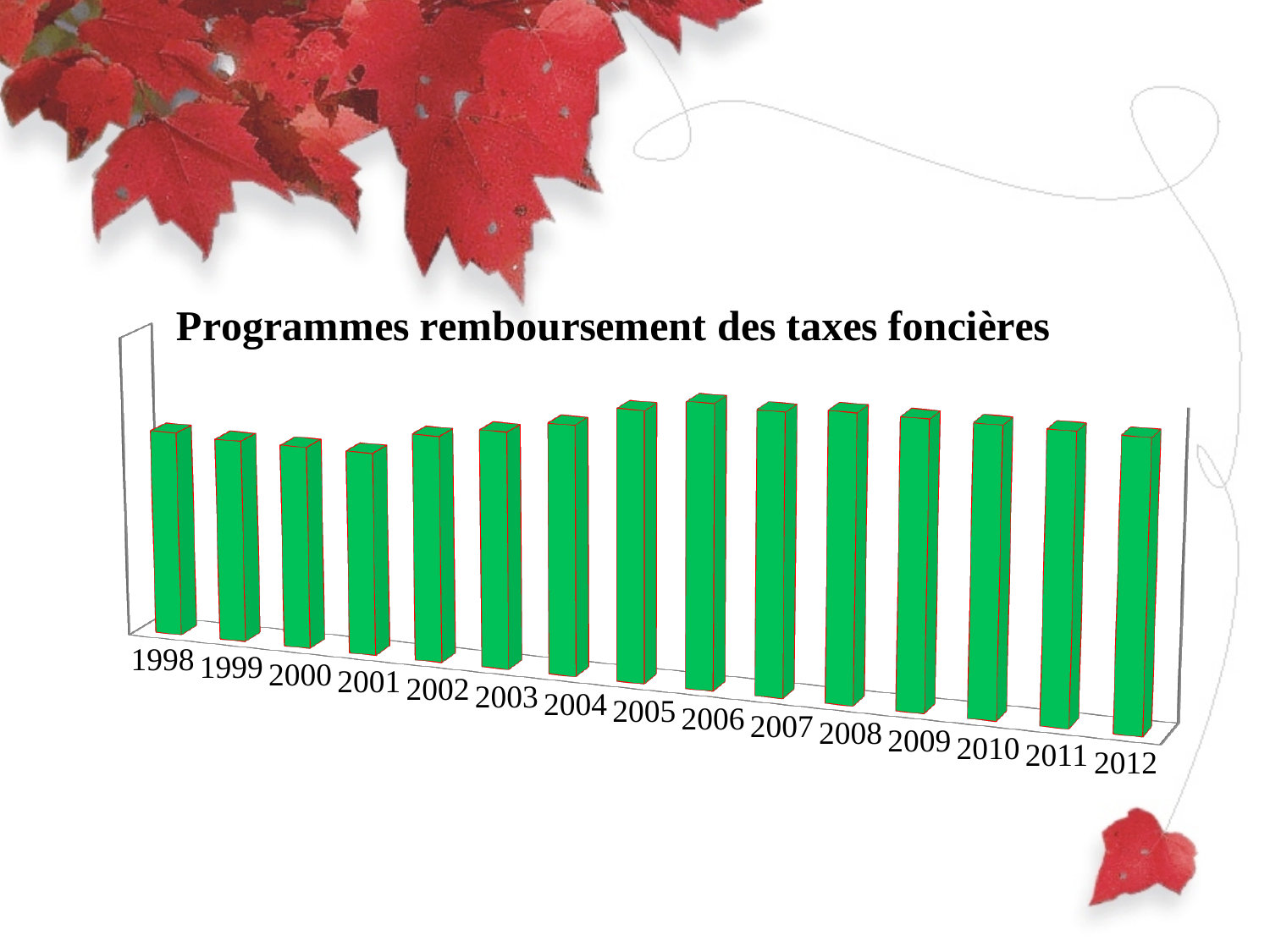
Do the bars rise or fall from 2001 to 2006? rise What kind of chart is shown on the slide? bar chart Which is larger, the bar for 1998 or the bar for 2005? 2005 What is the title of the chart? Programmes remboursement des taxes foncières What colour are the bars in the chart? green How many years (bars) are plotted in the chart? 15 Which year is the first category on the x axis? 1998 Which is larger, the bar for 2001 or the bar for 2006? 2006 Which year is the last category on the x axis? 2012